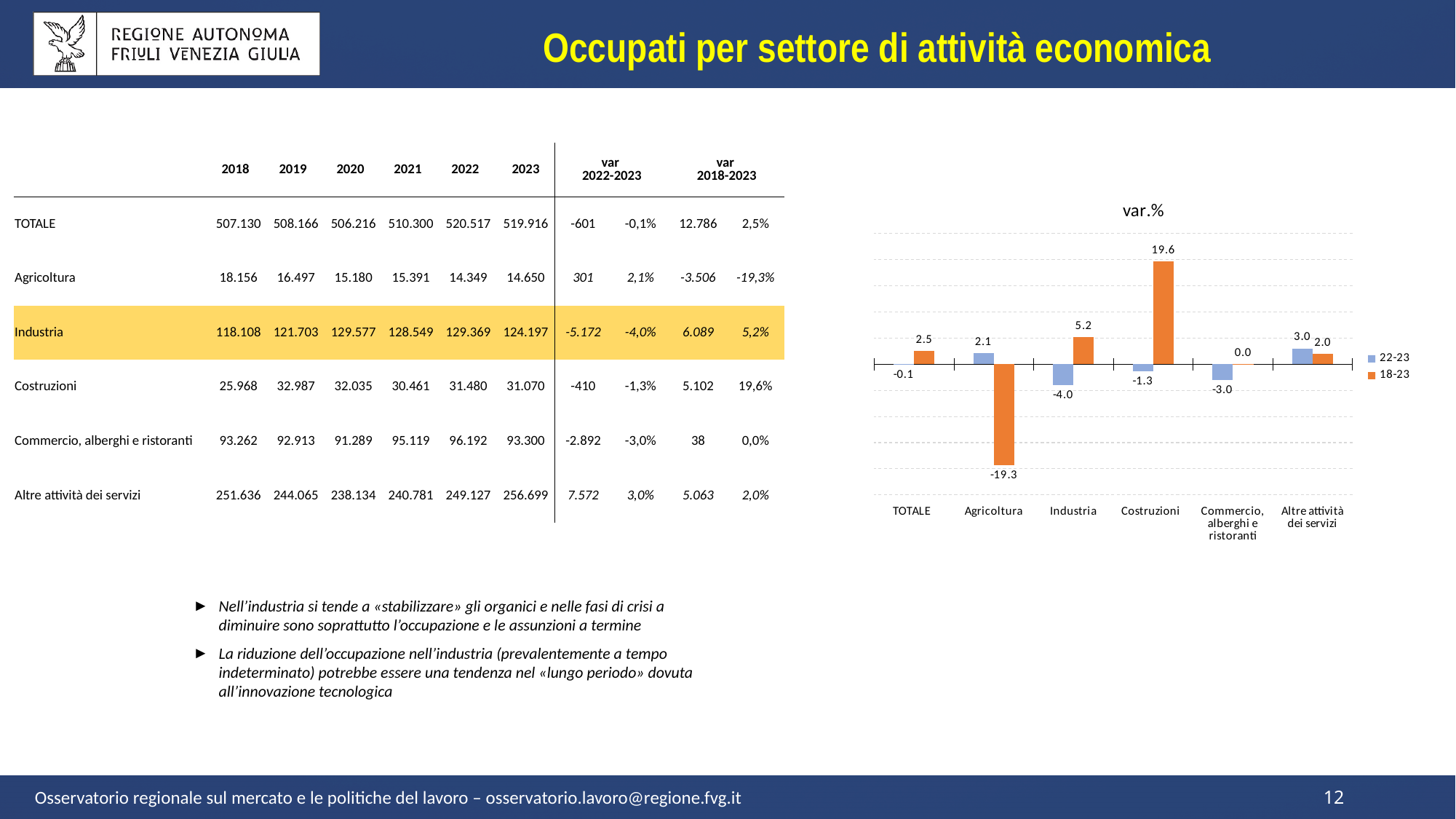
Which is larger, the 22-23 value for Agricoltura or the 22-23 value for Altre attività dei servizi? Altre attività dei servizi How many categories are shown on the x axis of the chart? 6 What type of chart is shown on the slide? bar chart What is the 18-23 value for Costruzioni? 19.6 Which category has the lowest 22-23 value? Industria What is the title of the chart? var.% What is the difference between the 18-23 value for Costruzioni and the 18-23 value for Industria? 14.4 How many series does the chart legend list? 2 Which series is shown in orange in the chart? 18-23 What is the 22-23 value for Industria? -4.0 What is the 18-23 value for Agricoltura? -19.3 Which category has the highest 18-23 value? Costruzioni